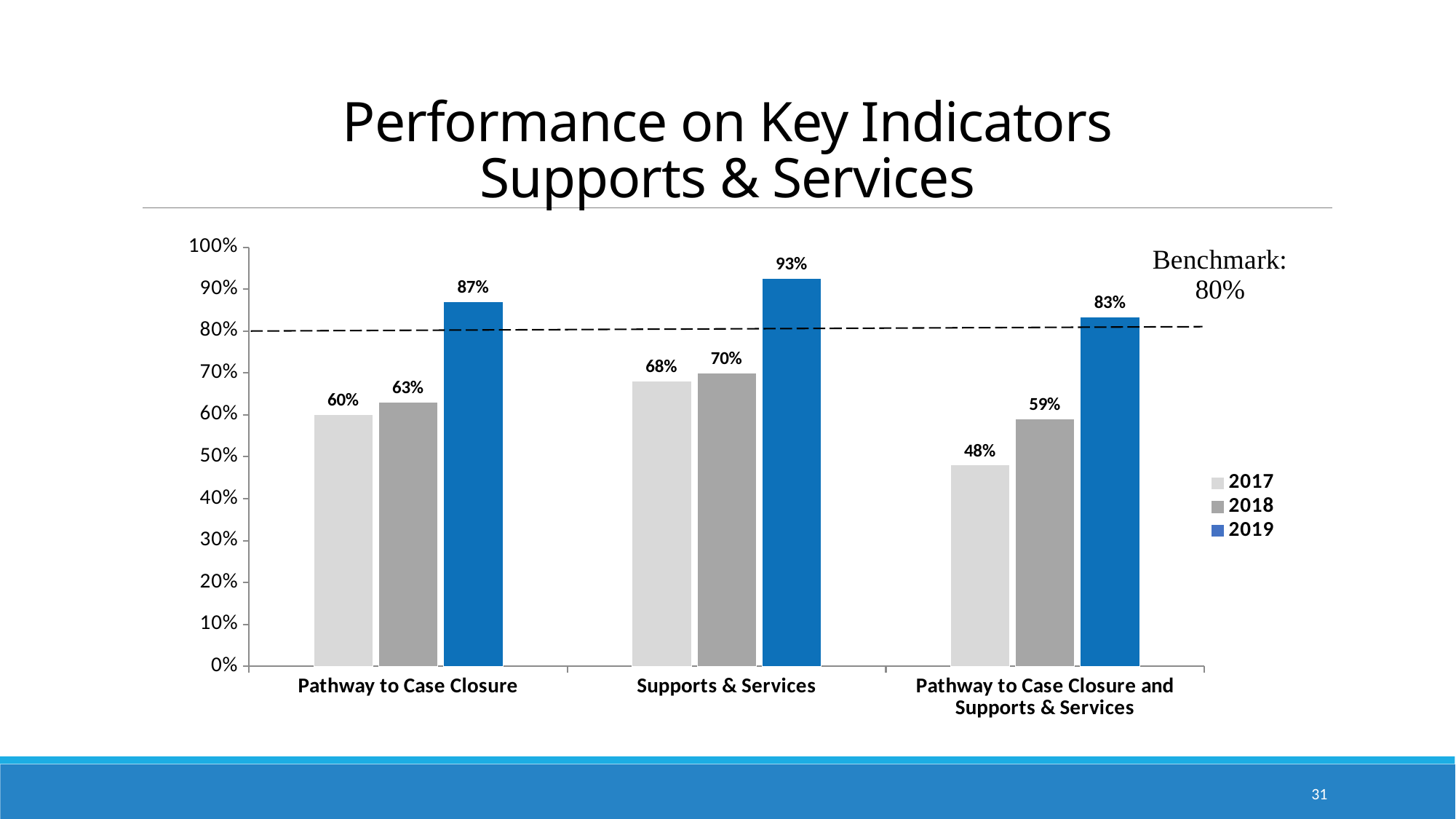
What is the difference between the 2019 and 2018 values for Pathway to Case Closure? 24% How many series does the legend list? 3 What is the 2019 value for Supports & Services? 93% What is the 2017 value for Pathway to Case Closure and Supports & Services? 48% How many categories are shown on the x axis? 3 Which category has the highest 2019 value? Supports & Services What benchmark value is marked by the dashed line on the chart? 80% Which is larger: the 2018 value for Supports & Services or the 2018 value for Pathway to Case Closure? Supports & Services Which category has the lowest 2017 value? Pathway to Case Closure and Supports & Services What is the 2018 value for Pathway to Case Closure? 63% Is the 2019 value for Pathway to Case Closure and Supports & Services greater or less than 80%? greater What kind of chart is shown on the slide? bar chart